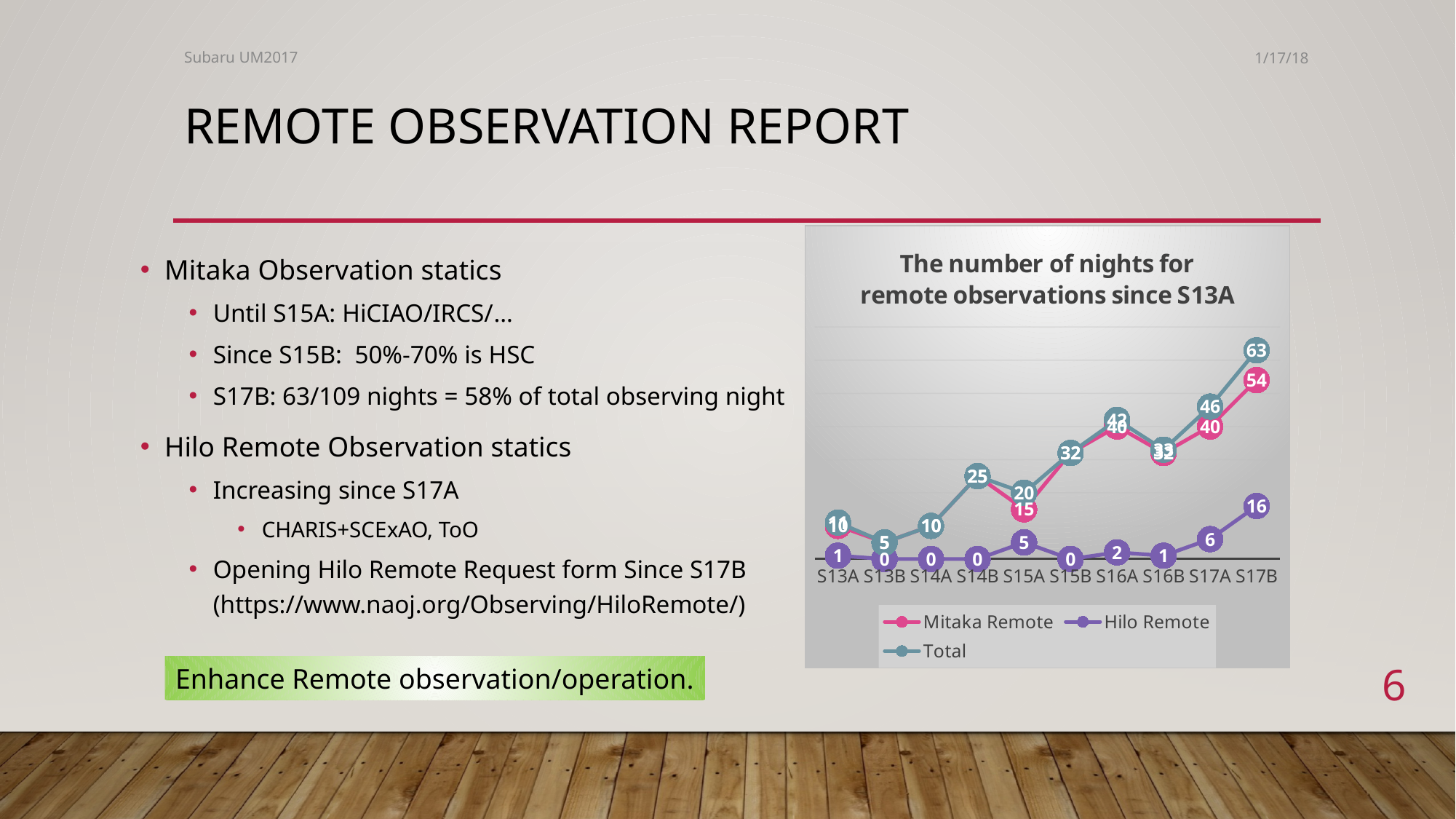
How many semesters are plotted along the x axis of the chart? 10 What is the Total value for S17B? 63 What kind of chart is shown on the slide? line chart What is the title of the chart? The number of nights for remote observations since S13A For S15A, which is larger: the Mitaka Remote value or the Total value? Total How many series does the chart legend list? 3 What is the Hilo Remote value for S17A? 6 What is the Mitaka Remote value for S17B? 54 What is the Total value for S14B? 25 What is the difference between the Total and Mitaka Remote values for S17B? 9 In which semester is the Hilo Remote value highest? S17B What is the Hilo Remote value for S17B? 16